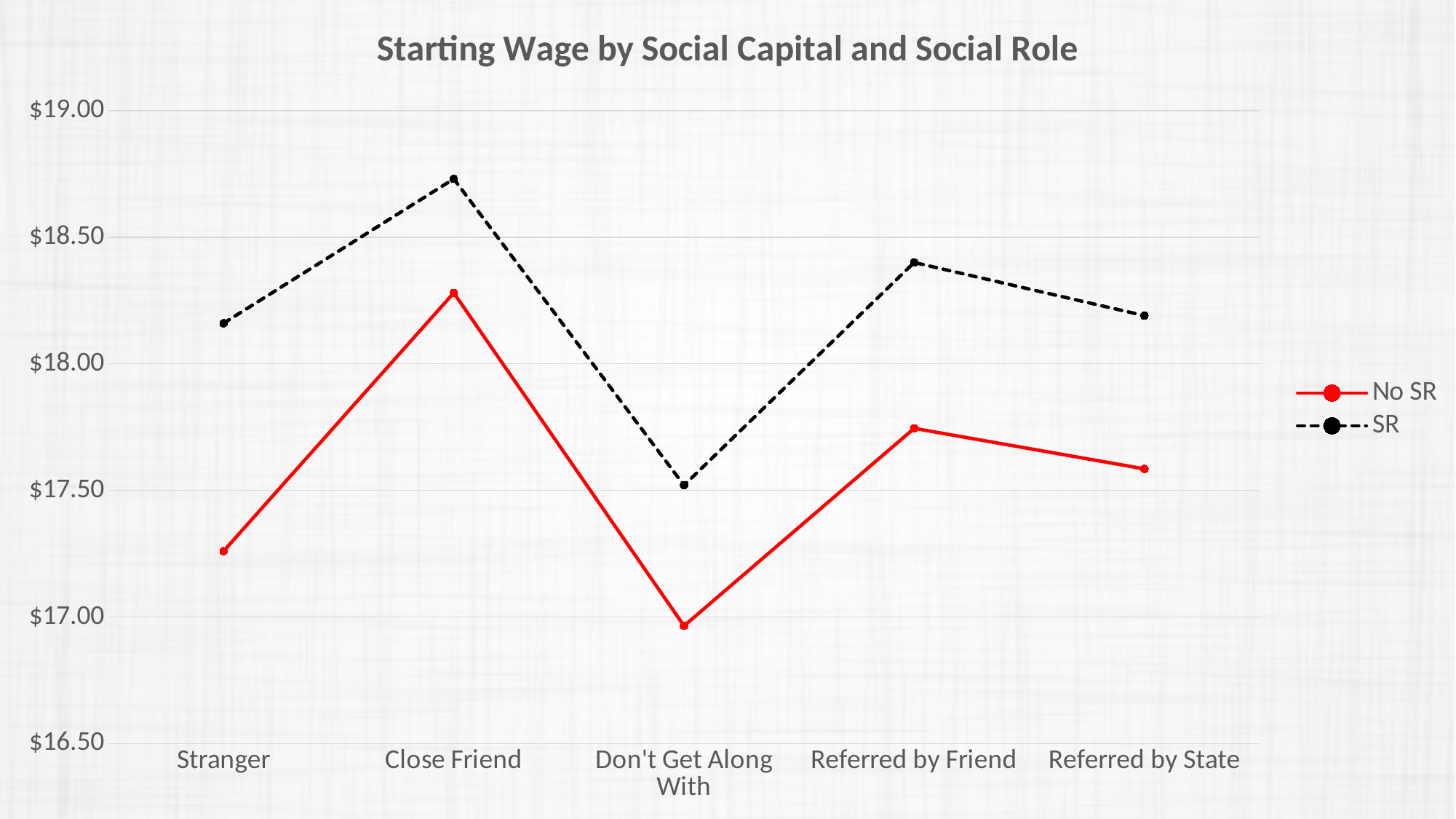
For which category is the No SR series highest? Close Friend Is the No SR value for Referred by Friend greater or less than $17.50? greater Is the No SR value for Stranger greater or less than $17.50? less Is the SR value for Close Friend greater or less than $18.50? greater For Stranger, which series has the higher starting wage, SR or No SR? SR Does the No SR series rise or fall from Close Friend to Don't Get Along With? fall How many categories are shown on the x axis? 5 What is the title of the chart? Starting Wage by Social Capital and Social Role How many series does the legend list? 2 What kind of chart is shown on the slide? line chart For which category is the SR series lowest? Don't Get Along With